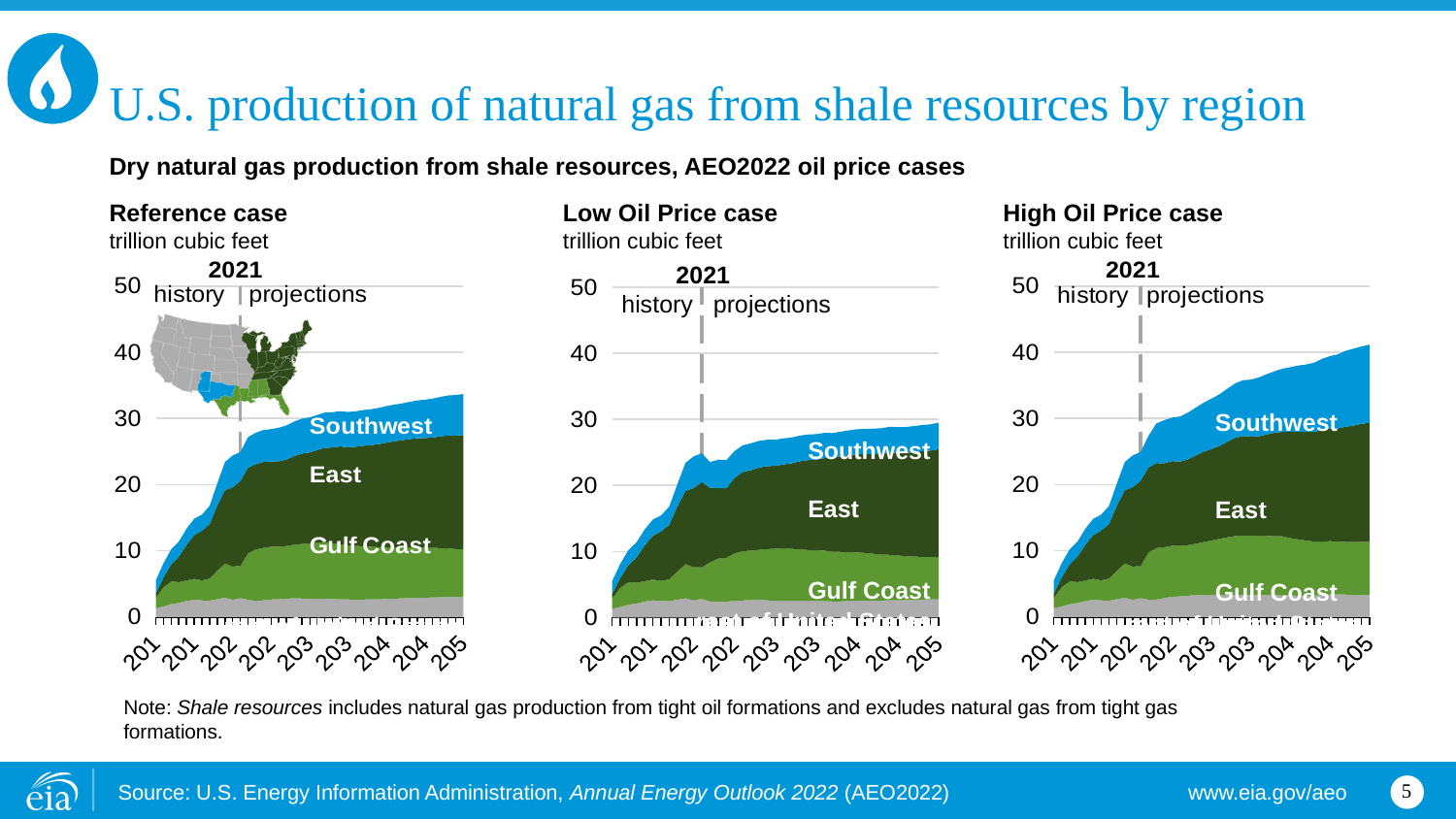
In the Reference case chart, is the total shale gas production at the end of the projection (2050) greater or less than 30 trillion cubic feet? greater In the Reference case chart, is the total production in 2010 greater or less than 10 trillion cubic feet? less Which of the three cases shows the lowest total shale gas production in 2050? Low Oil Price case In the Reference case chart, does total shale gas production rise or fall over the projection period? rise What kind of chart is the Reference case chart? stacked area chart What unit is used on the y axis of the charts? trillion cubic feet Which of the three cases shows the highest total shale gas production in 2050? High Oil Price case In the High Oil Price case chart, which region is the largest contributor to production in 2050, East or Gulf Coast? East Which year does the dashed vertical line separating history from projections mark? 2021 How many charts are shown on the slide? 3 In the High Oil Price case chart, is the total shale gas production in 2050 greater or less than 30 trillion cubic feet? greater